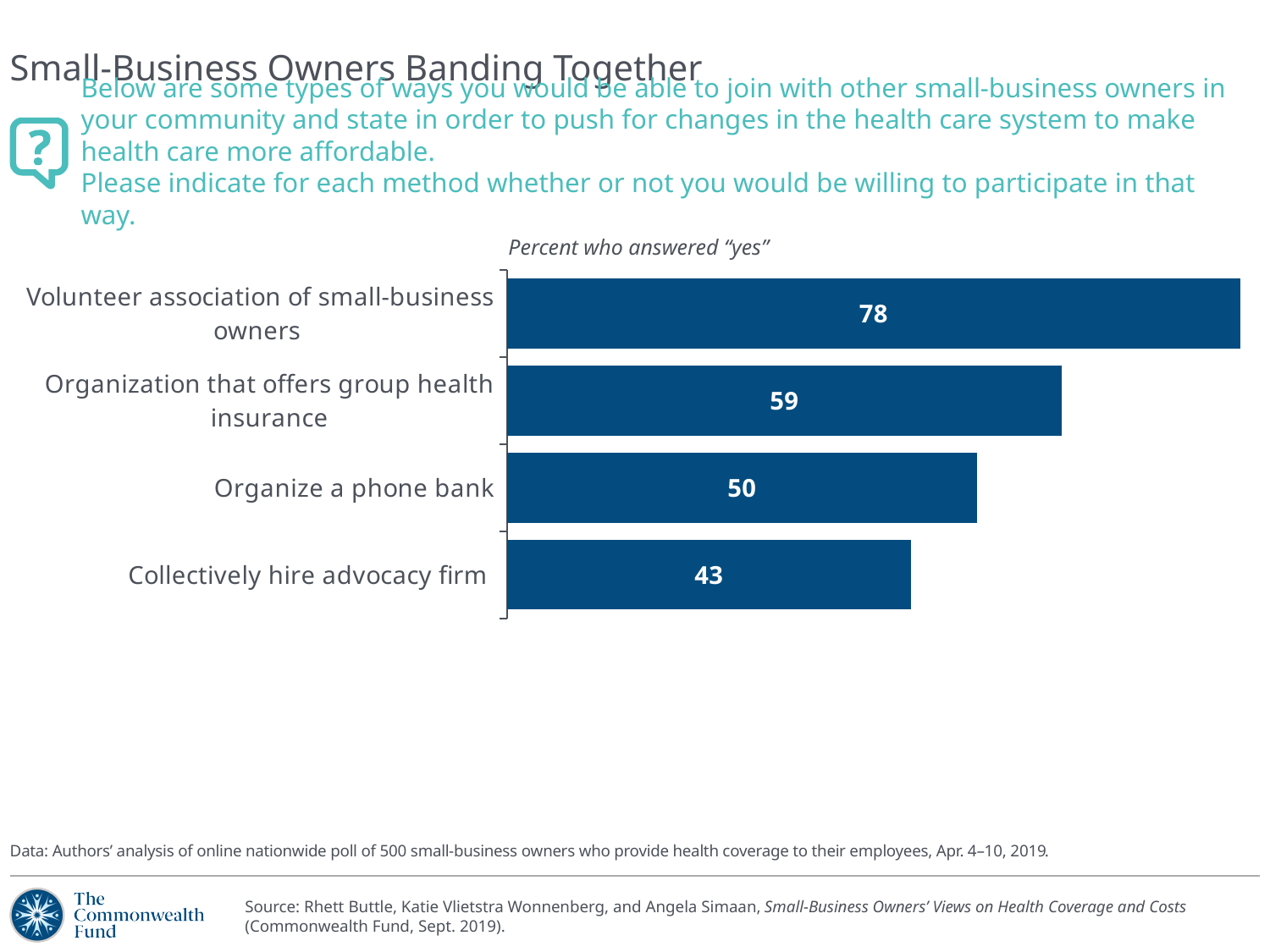
What percent answered "yes" to joining a volunteer association of small-business owners? 78 What is the difference in percent who answered "yes" between the volunteer association of small-business owners and collectively hiring an advocacy firm? 35 How many methods are shown in the chart? 4 What percent answered "yes" to an organization that offers group health insurance? 59 What is the difference in percent who answered "yes" between an organization that offers group health insurance and organizing a phone bank? 9 What kind of chart is shown on the slide? Bar chart What percent answered "yes" to collectively hiring an advocacy firm? 43 Which method has the highest percent who answered "yes"? Volunteer association of small-business owners What percent answered "yes" to organizing a phone bank? 50 What does the label above the chart say the values represent? Percent who answered "yes" Which has a higher percent who answered "yes": organizing a phone bank or collectively hiring an advocacy firm? Organize a phone bank Which method has the lowest percent who answered "yes"? Collectively hire advocacy firm